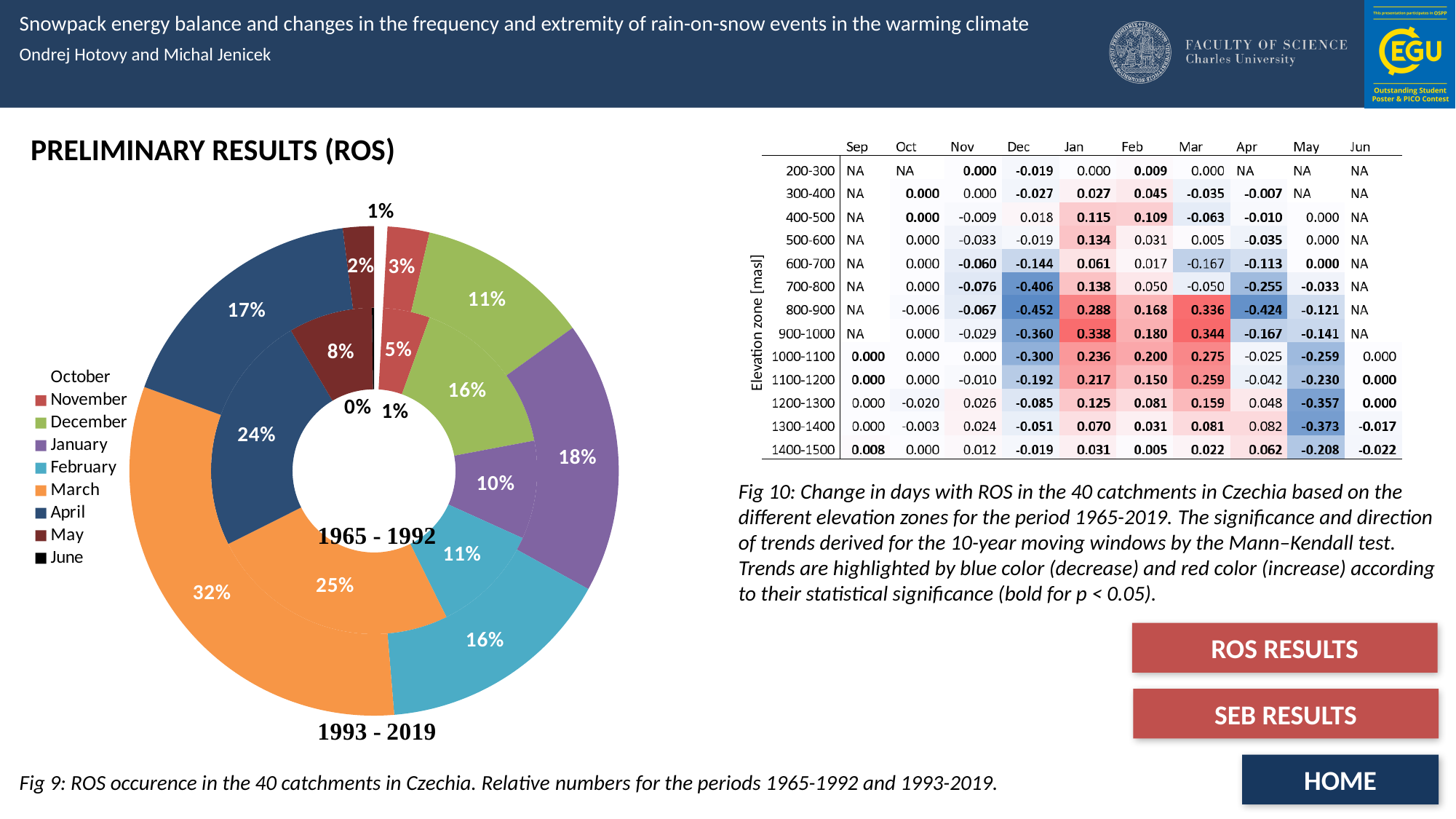
In the doughnut chart, which month has the largest share in the 1993 - 2019 period? March In the doughnut chart, what is the April share for the 1993 - 2019 period? 17% In the doughnut chart, what is the difference between the April share in 1965 - 1992 and in 1993 - 2019? 7 percentage points What type of chart is shown in Fig 9 on the left of the slide? Doughnut chart In the doughnut chart, which period is shown by the inner ring? 1965 - 1992 In the doughnut chart, is the January share larger in 1965 - 1992 or in 1993 - 2019? 1993 - 2019 In the doughnut chart, what share of ROS occurrence does March have in the 1993 - 2019 period? 32% In the doughnut chart, what is the December share for the 1965 - 1992 period? 16% In the doughnut chart, what is the May share for the 1965 - 1992 period? 8% In the doughnut chart, by how many percentage points did the March share change from 1965 - 1992 to 1993 - 2019? 7 percentage points In the doughnut chart, what share of ROS occurrence does March have in the 1965 - 1992 period? 25% How many months does the legend of the doughnut chart list? 9